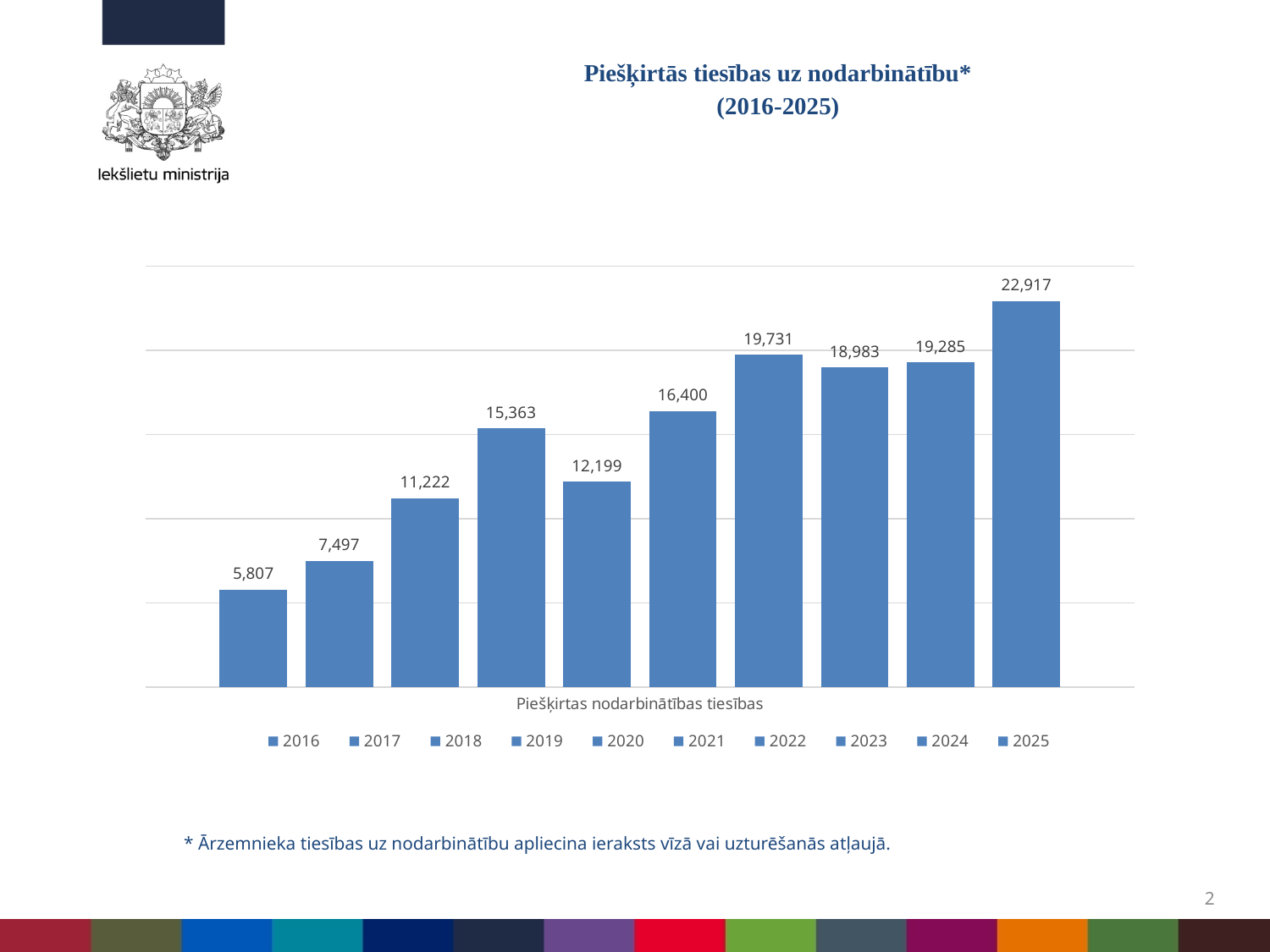
How many years are shown in the chart? 10 What is the difference between the values for 2019 and 2020? 3,164 Which year has the lowest value? 2016 Which year has the highest value? 2025 What is the value for 2024? 19,285 What is the value for 2021? 16,400 How many entries does the legend list? 10 What is the title of the chart? Piešķirtās tiesības uz nodarbinātību* (2016-2025) What is the difference between the values for 2025 and 2024? 3,632 What is the value for 2016? 5,807 Which is larger, the value for 2022 or the value for 2023? 2022 What kind of chart is shown on the slide? bar chart